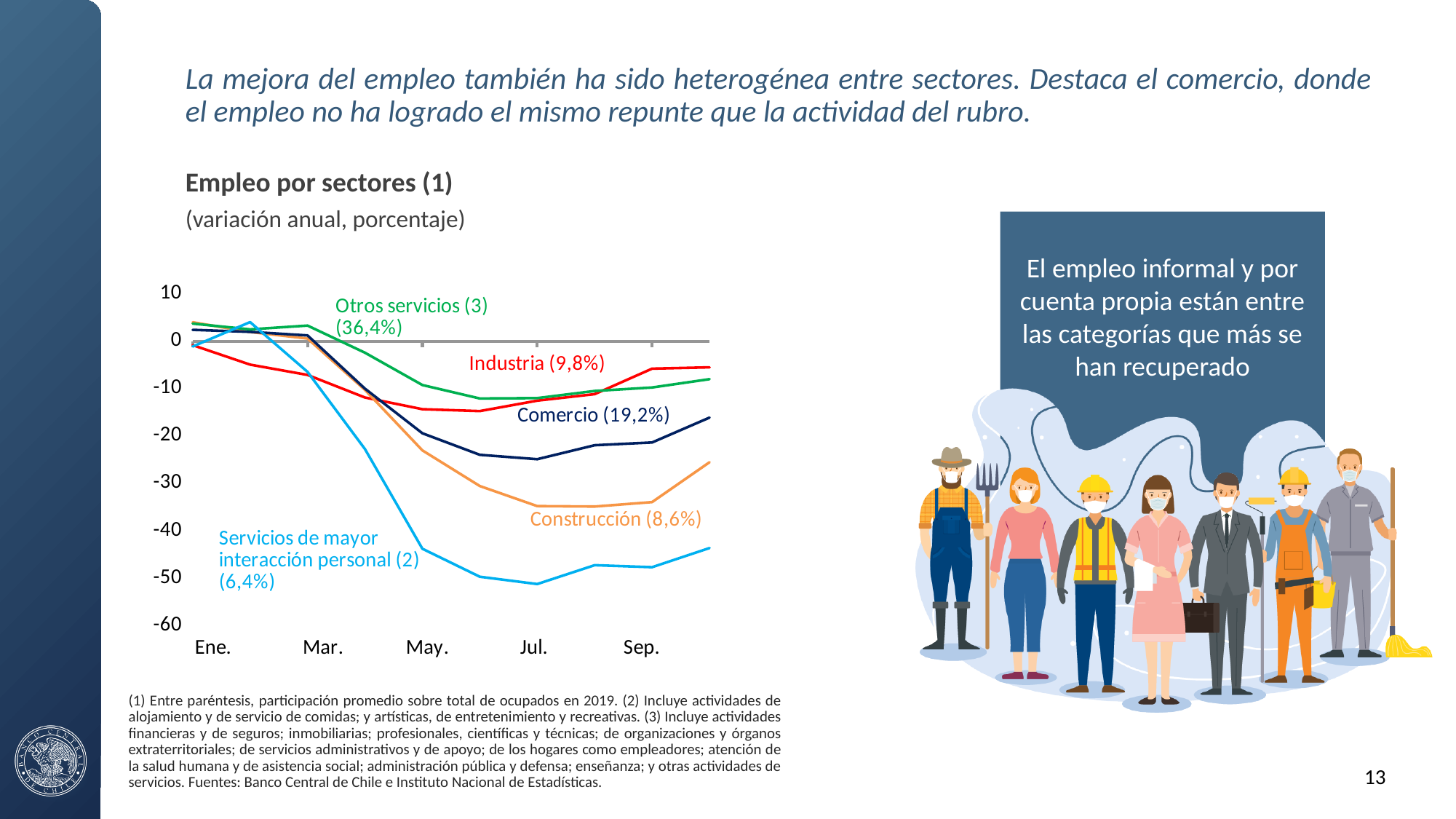
Which series has the lowest value in Jul.? Servicios de mayor interacción personal (2) Is the value for Comercio in Jul. greater or less than -20? less How many month labels are shown on the x axis of the chart? 5 Is the value for Servicios de mayor interacción personal (2) in Jul. greater or less than -40? less How many series are plotted in the chart? 5 Is the value for Industria in Sep. greater or less than -10? greater Does the Servicios de mayor interacción personal (2) series rise or fall from Ene. to Jul.? fall What is the title of the chart? Empleo por sectores (1) In Jul., which is higher: Comercio or Construcción? Comercio What share of total employment is shown in parentheses next to the Comercio label? 19,2% What kind of chart is shown on the slide? line chart